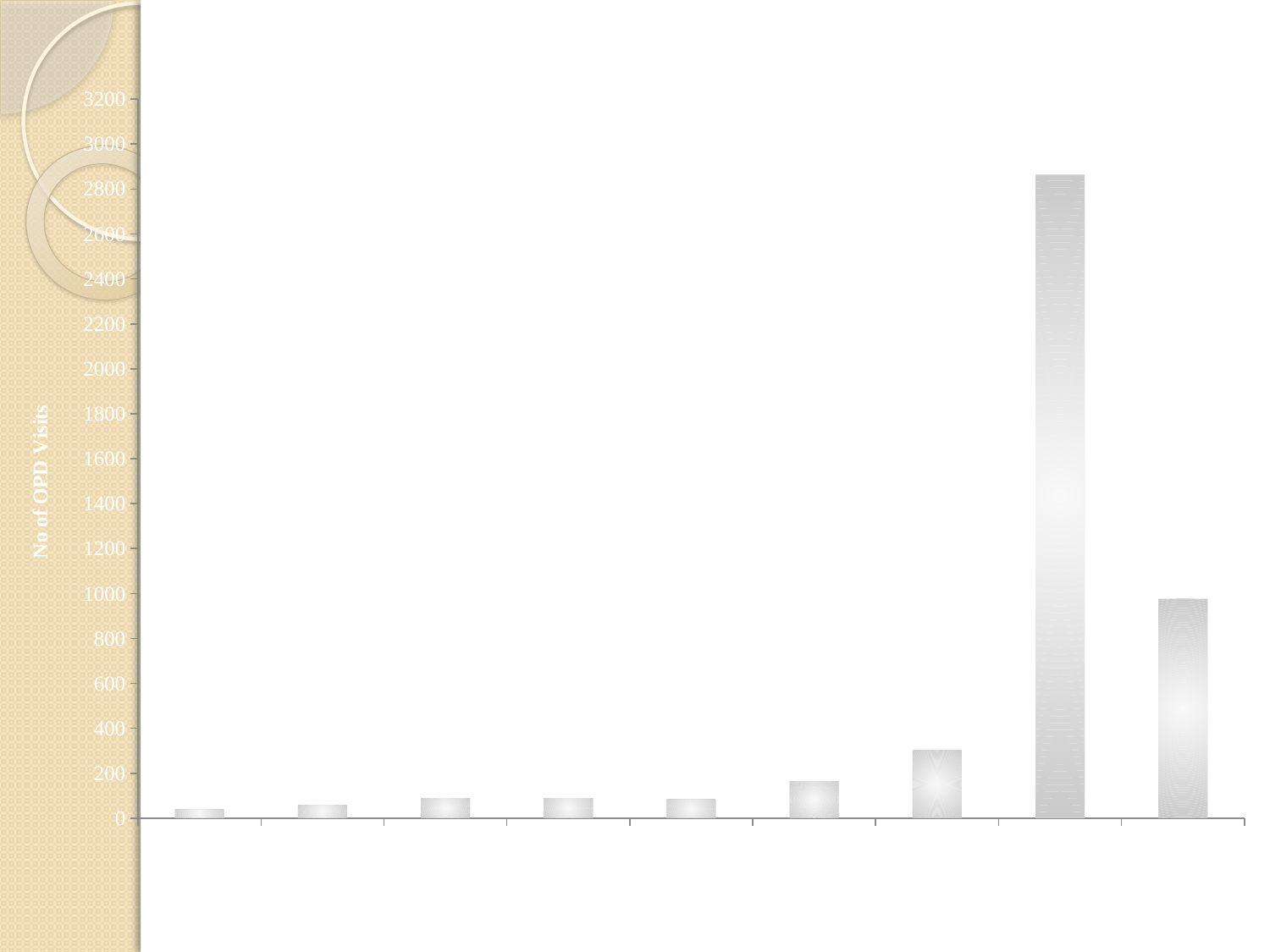
Is the value of the last (rightmost) bar greater or less than 800? greater What is the label on the vertical axis of the chart? No of OPD Visits Is the value of the first bar from the left greater or less than 200? less Is the value of the tallest bar greater or less than 2600? greater What is the highest tick value shown on the vertical axis? 3200 Which bar is the tallest in the chart, counting from the left? the eighth bar How many bars are plotted in the chart? 9 Which is larger, the eighth bar from the left or the ninth bar from the left? the eighth bar Which bar is the shortest in the chart, counting from the left? the first bar What kind of chart is shown on the slide? bar chart